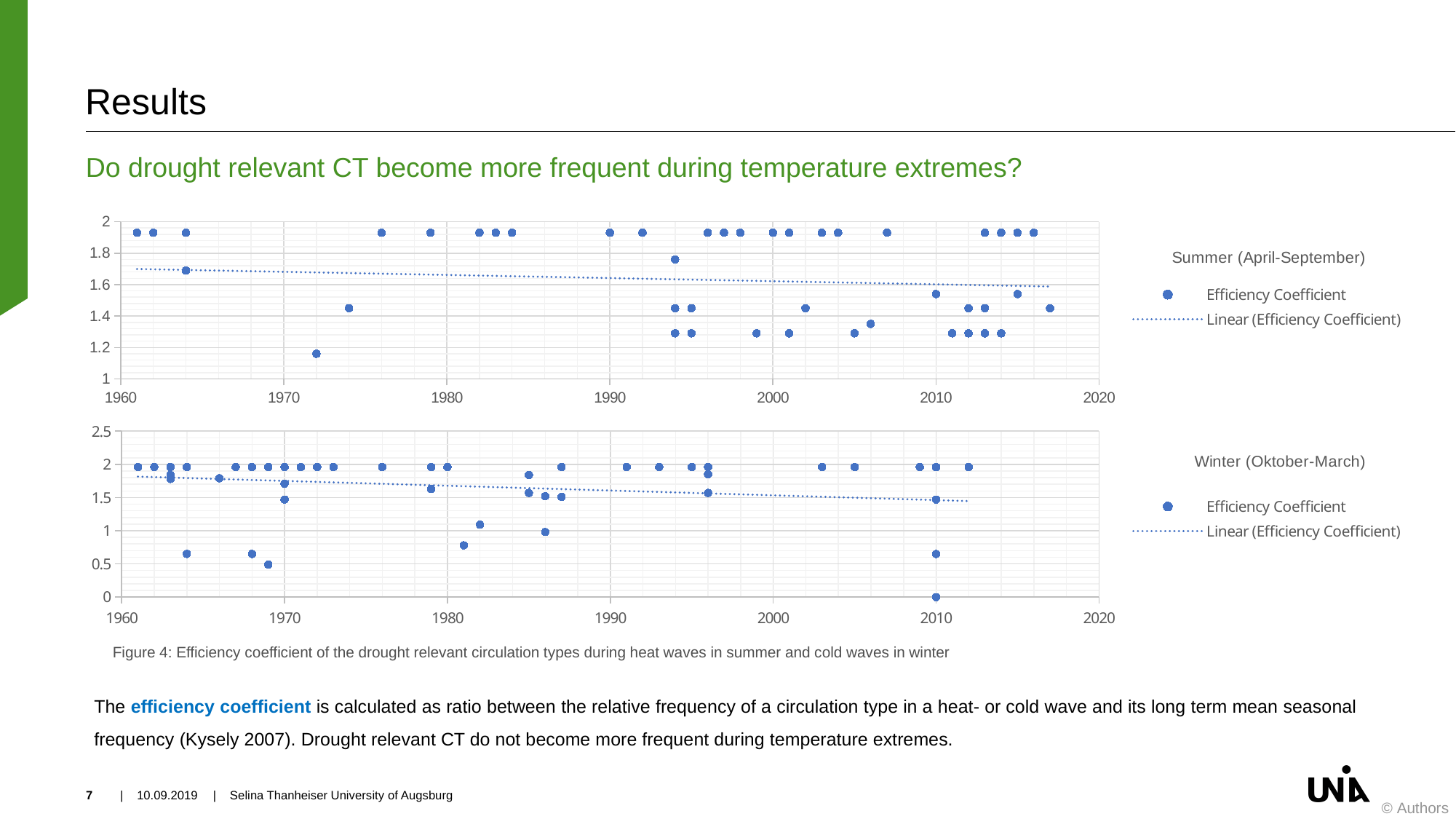
In the Winter (Oktober-March) chart, is the lowest point in 1964 greater or less than 0.5? greater In the Winter (Oktober-March) chart, does the linear trend line rise or fall along the x axis? fall What kind of chart is the Summer (April-September) chart? scatter chart How many series does the legend of the Summer (April-September) chart list? 2 In the Summer (April-September) chart, is the value for 1972 greater or less than 1.2? less In the Summer (April-September) chart, in which year does the lowest efficiency coefficient point occur? 1972 In the Winter (Oktober-March) chart, is the lowest point in 2010 greater or less than 0.5? less In the Summer (April-September) chart, does the linear trend line rise or fall from 1960 to 2020? fall What are the two legend entries of the Winter (Oktober-March) chart? Efficiency Coefficient; Linear (Efficiency Coefficient) What is the title of the lower chart? Winter (Oktober-March) In the Winter (Oktober-March) chart, in which year does the lowest efficiency coefficient point occur? 2010 How many charts are shown on the slide? 2